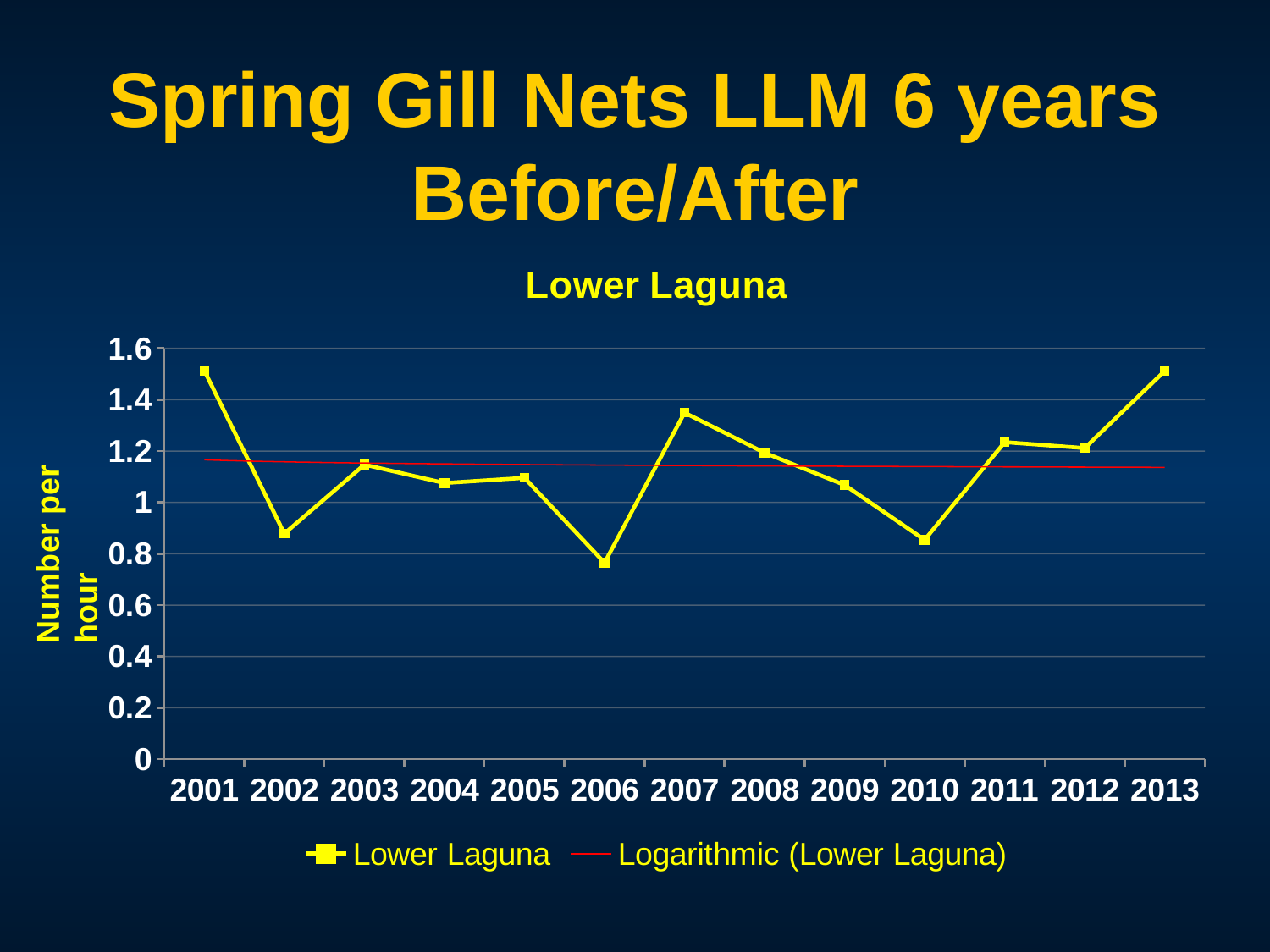
What is the label on the y axis? Number per hour Do the values rise or fall from 2010 to 2013? rise Is the value for 2001 greater or less than 1.4? greater How many years are plotted along the x axis? 13 Is the value for 2002 greater or less than 1? less What kind of chart is shown on the slide? line chart Which year has the lowest value for Lower Laguna? 2006 Is the value for 2010 greater or less than 1? less Which year has the larger value, 2007 or 2008? 2007 How many entries does the legend list? 2 What type of trendline is shown in the legend for Lower Laguna? Logarithmic